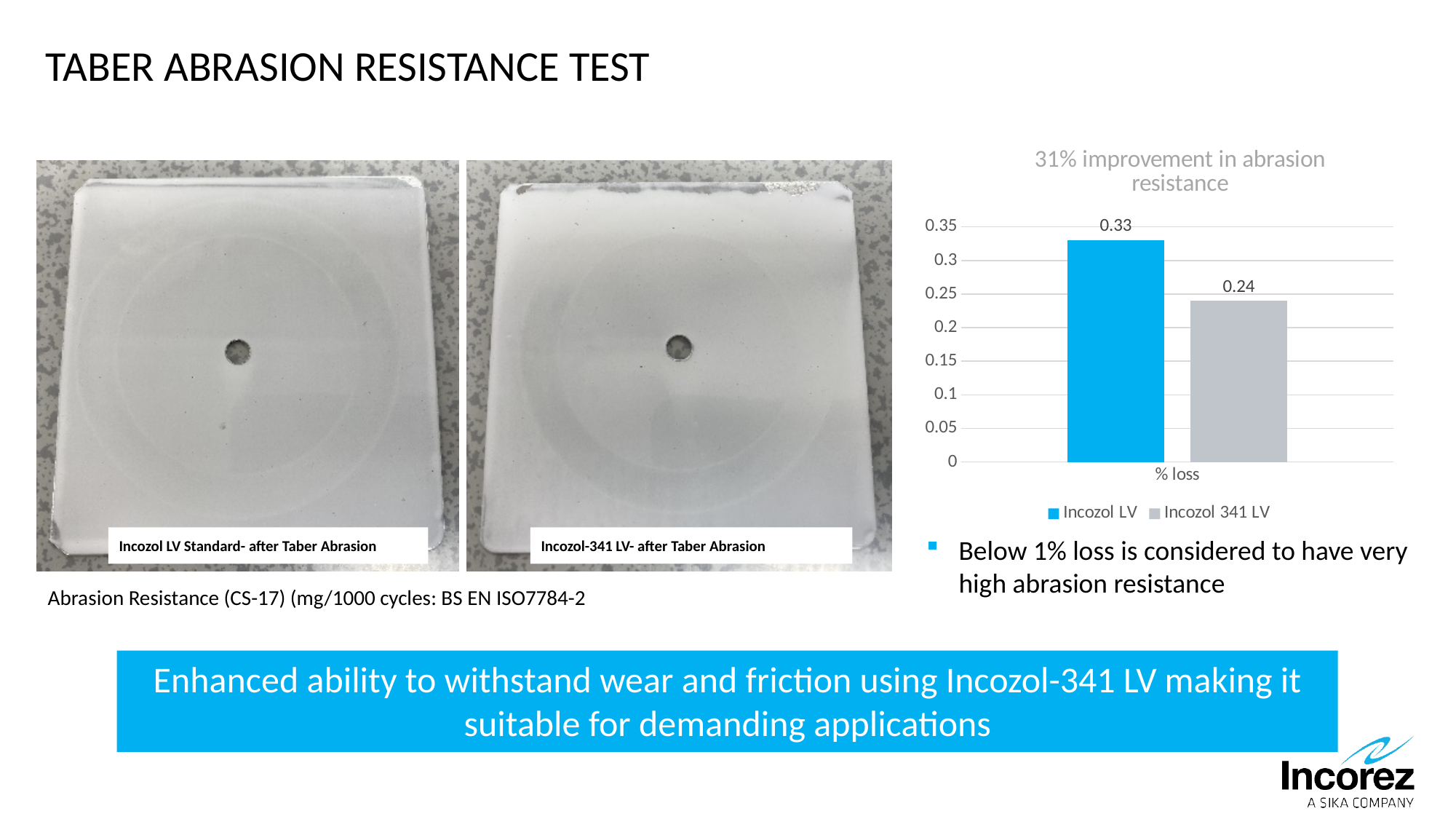
Is the % loss for Incozol LV greater or less than 0.3? greater What is the highest value shown on the chart's y axis? 0.35 What type of chart is shown on the slide? Bar chart How many series does the chart legend list? 2 What is the difference in % loss between Incozol LV and Incozol 341 LV? 0.09 Which series has the higher % loss, Incozol LV or Incozol 341 LV? Incozol LV What is the title of the chart? 31% improvement in abrasion resistance What is the % loss value for Incozol LV? 0.33 What is the category label on the x axis of the chart? % loss What is the % loss value for Incozol 341 LV? 0.24 Is the % loss for Incozol 341 LV greater or less than 0.25? less Which series has the lowest % loss? Incozol 341 LV